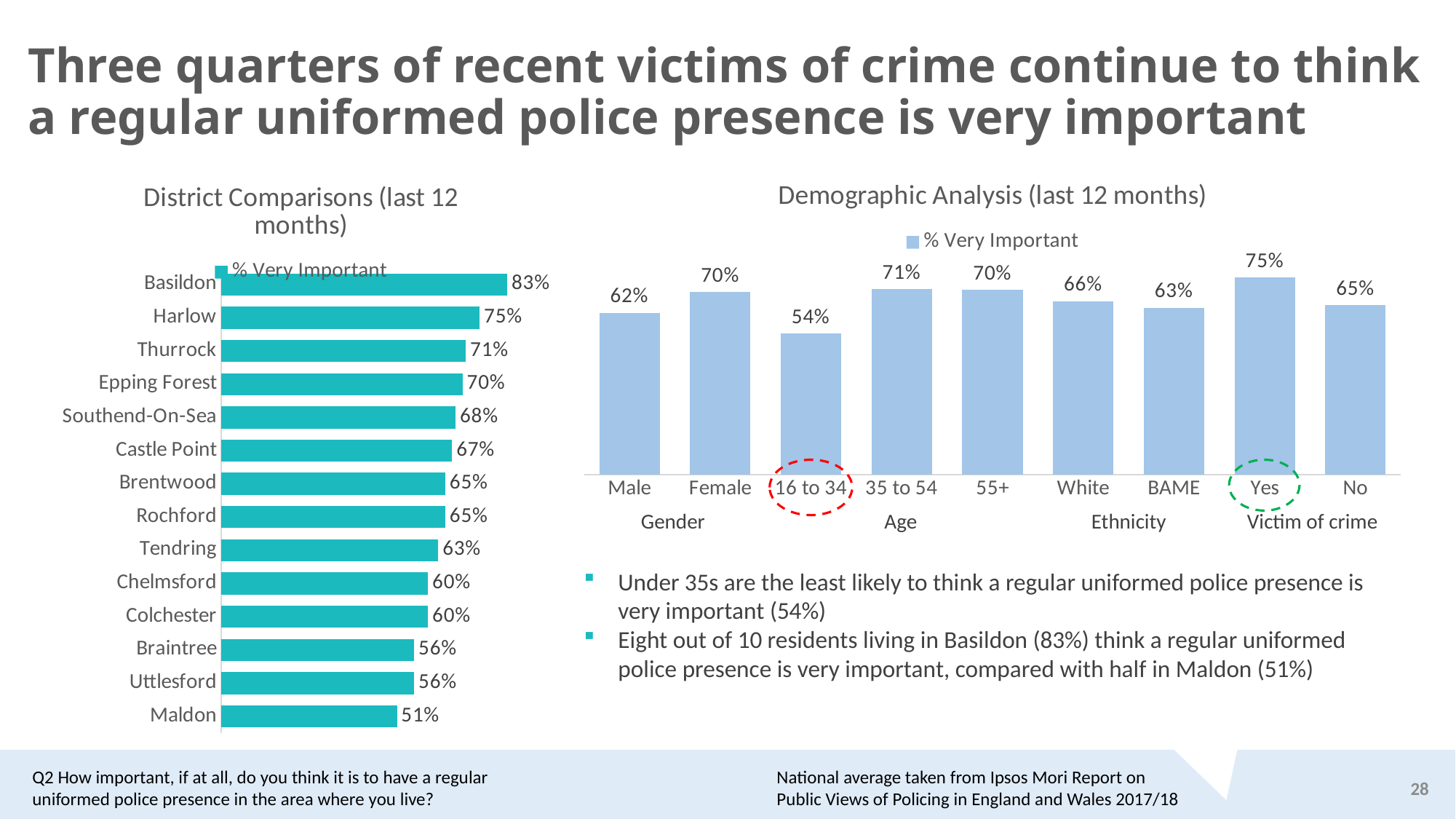
What kind of chart is the Demographic Analysis chart? Bar chart In the District Comparisons chart, what is the value for Southend-On-Sea? 68% In the Demographic Analysis chart, which is larger, Male or Female? Female In the District Comparisons chart, how many districts are shown? 14 In the District Comparisons chart, which district has the lowest value? Maldon In the Demographic Analysis chart, what is the difference between Female and Male? 8% In the District Comparisons chart, which district has the highest value? Basildon In the Demographic Analysis chart, what is the value for 16 to 34? 54% In the District Comparisons chart, what is the difference between Basildon and Maldon? 32% In the Demographic Analysis chart, how many categories are shown? 9 In the District Comparisons chart, what is the value for Harlow? 75% In the Demographic Analysis chart, which category has the highest value? Yes